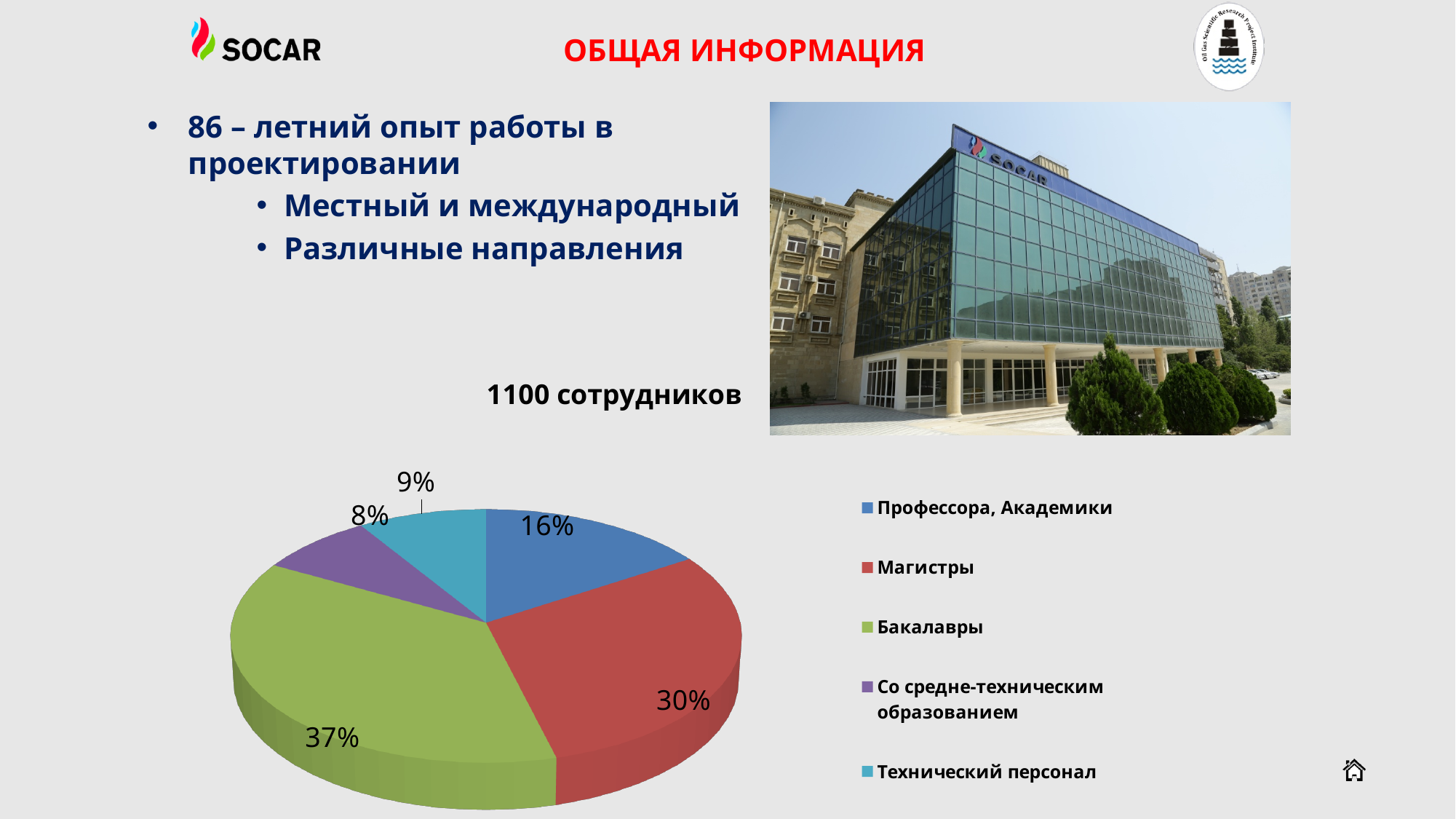
What share of the pie chart is labelled for Бакалавры? 37% What share of the pie chart is labelled for Со средне-техническим образованием? 8% Which category has the largest slice of the pie chart? Бакалавры How many categories does the pie chart legend list? 5 Which slice is larger: Профессора, Академики or Технический персонал? Профессора, Академики What share of the pie chart is labelled for Технический персонал? 9% What share of the pie chart is labelled for Магистры? 30% What is the difference in percentage points between the Бакалавры slice and the Магистры slice? 7 What share of the pie chart is labelled for Профессора, Академики? 16% What is the title shown above the pie chart? 1100 сотрудников What kind of chart is shown on the slide? Pie chart Which category has the smallest slice of the pie chart? Со средне-техническим образованием